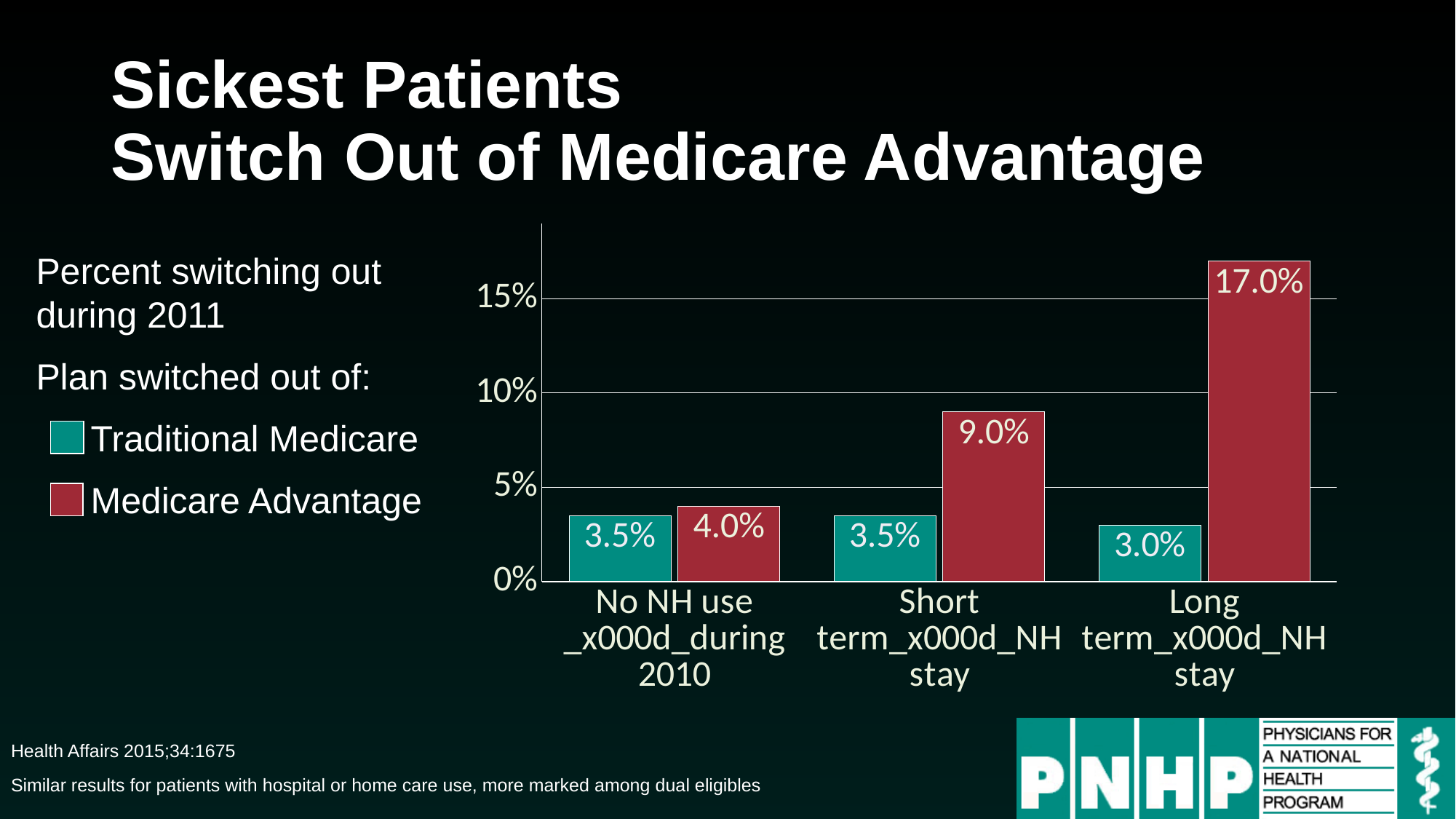
What is the difference between the Medicare Advantage values for Long term NH stay and Short term NH stay? 8.0% What is the difference between the Medicare Advantage and Traditional Medicare values for the Short term NH stay category? 5.5% Which is larger for the Long term NH stay category: Traditional Medicare or Medicare Advantage? Medicare Advantage What is the Medicare Advantage value for the Long term NH stay category? 17.0% Which category has the lowest Traditional Medicare value? Long term NH stay What is the Traditional Medicare value for the Long term NH stay category? 3.0% Which category has the highest Medicare Advantage value? Long term NH stay How many categories are shown on the x axis? 3 What kind of chart is shown on the slide? Bar chart What is the Medicare Advantage value for the No NH use during 2010 category? 4.0% How many series does the legend list? 2 What is the Traditional Medicare value for the Short term NH stay category? 3.5%